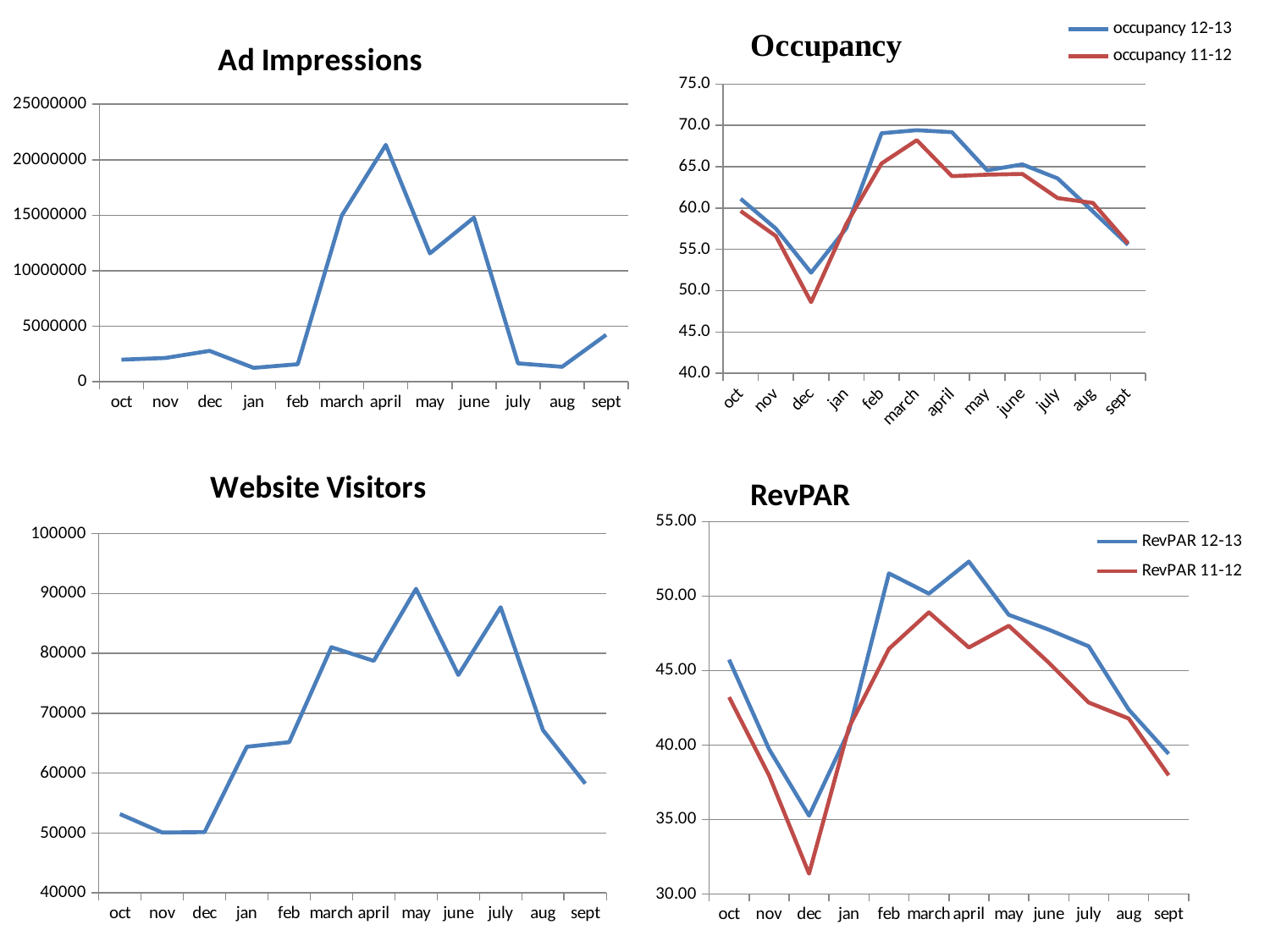
In the RevPAR chart, do the values for RevPAR 12-13 rise or fall from may to sept? fall In the Ad Impressions chart, is the value for oct greater or less than 5000000? less In the Website Visitors chart, which month has the highest value? may In the RevPAR chart, which month has the lowest value for RevPAR 11-12? dec In the Ad Impressions chart, is the value for april greater or less than 20000000? greater In the Occupancy chart, which month has the lowest value for occupancy 11-12? dec In the Website Visitors chart, is the value for sept greater or less than 60000? less In the Occupancy chart, which is larger in march: occupancy 12-13 or occupancy 11-12? occupancy 12-13 How many months are plotted on the Website Visitors chart? 12 How many series does the legend of the Occupancy chart list? 2 In the Ad Impressions chart, which month has the highest value? april What kind of chart is the Ad Impressions chart? line chart